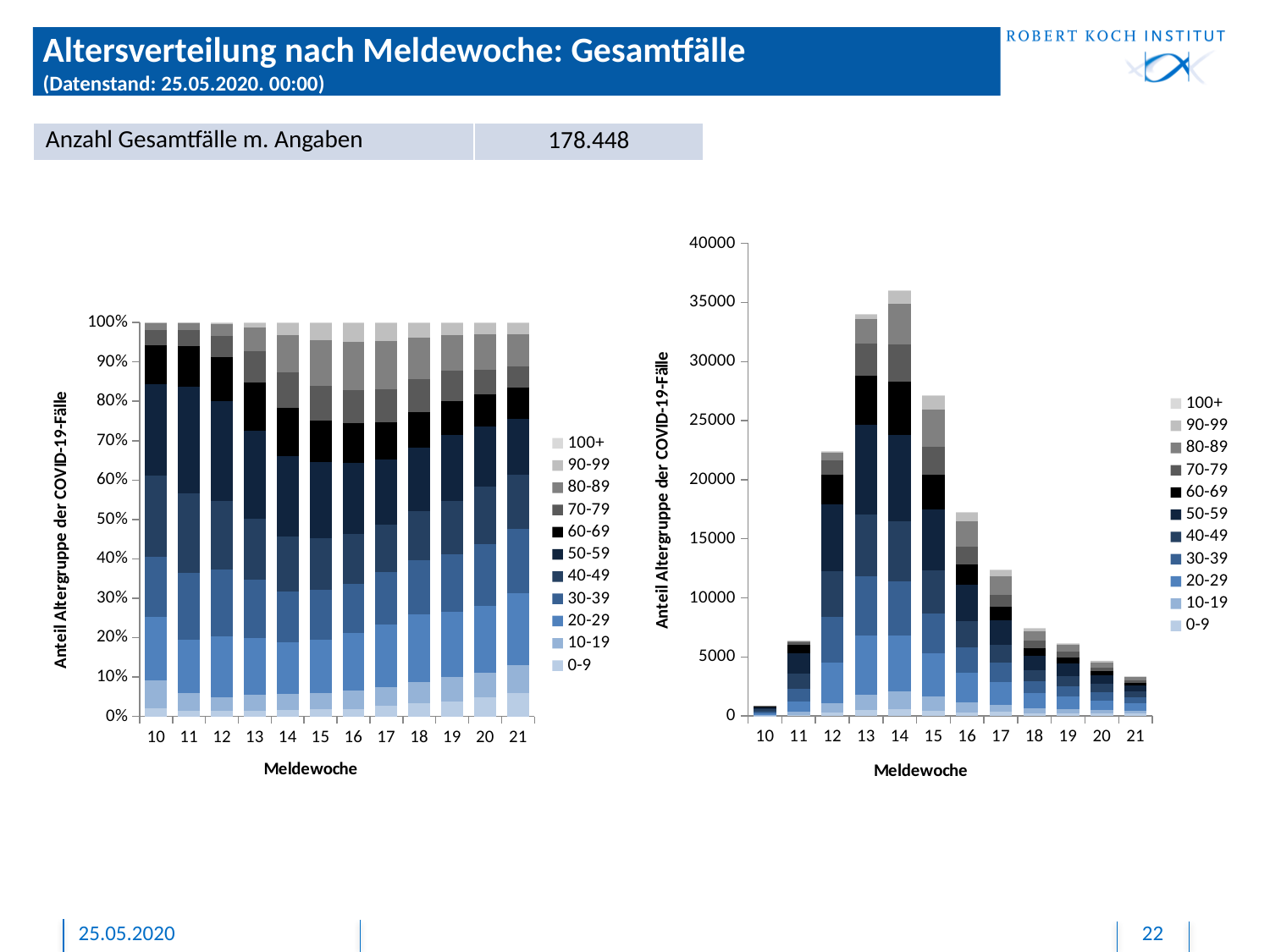
What is the x-axis label of the left chart? Meldewoche What kind of chart is the chart on the right of the slide? stacked bar chart What is the y-axis label of the right chart? Anteil Altergruppe der COVID-19-Fälle How many reporting weeks (Meldewoche) are shown on the x axis of the right chart? 12 In the right chart, which reporting week has the highest total number of cases? 14 In the right chart, is the total for week 15 greater or less than 25000? greater In the right chart, is the total for week 13 greater or less than 35000? less In the right chart, which week has a larger total number of cases, week 12 or week 15? week 15 In the right chart, do the total cases rise or fall from week 14 to week 21? fall In the right chart, which reporting week has the lowest total number of cases? 10 How many age groups does the legend of the left chart list? 11 In the right chart, is the total for week 21 greater or less than 5000? less